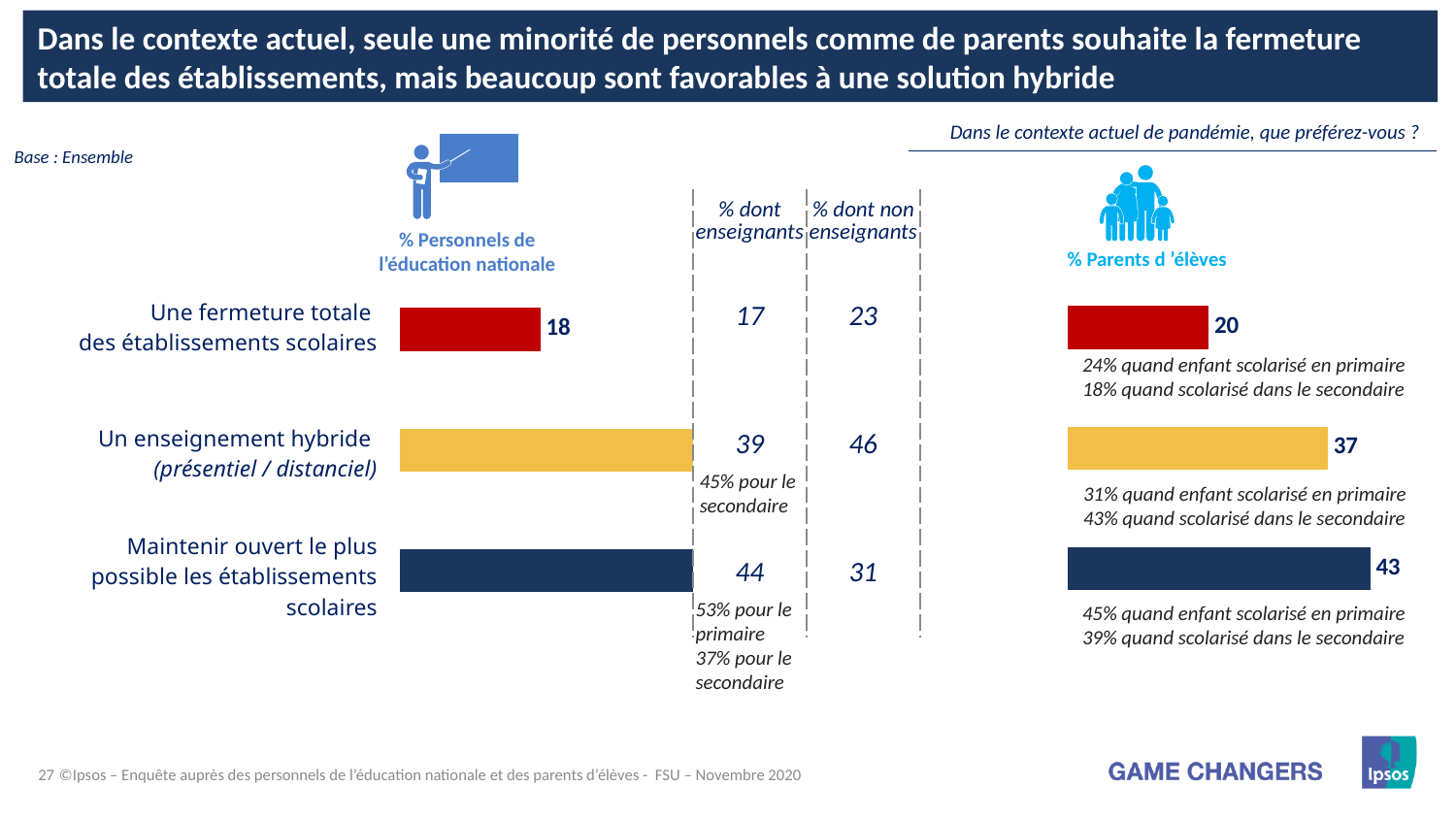
In the '% Parents d'élèves' chart, what is the value for 'Maintenir ouvert le plus possible les établissements scolaires'? 43 In the '% Personnels de l'éducation nationale' chart, what is the value for 'Une fermeture totale des établissements scolaires'? 18 In the '% Parents d'élèves' chart, which option has the lowest value? Une fermeture totale des établissements scolaires What type of chart is used for '% Personnels de l'éducation nationale'? Bar chart In the '% Parents d'élèves' chart, what is the value for 'Une fermeture totale des établissements scolaires'? 20 In the '% Parents d'élèves' chart, what is the difference between 'Maintenir ouvert le plus possible' and 'Une fermeture totale'? 23 For 'Une fermeture totale des établissements scolaires', which is larger: the value in the '% Personnels de l'éducation nationale' chart or the value in the '% Parents d'élèves' chart? % Parents d'élèves In the '% Parents d'élèves' chart, what is the value for 'Un enseignement hybride (présentiel / distanciel)'? 37 How many options (categories) are shown in the '% Parents d'élèves' chart? 3 In the '% Personnels de l'éducation nationale' chart, which option has the shortest bar? Une fermeture totale des établissements scolaires In the '% Parents d'élèves' chart, what is the difference between 'Maintenir ouvert le plus possible' and 'Un enseignement hybride'? 6 In the '% Parents d'élèves' chart, which option has the highest value? Maintenir ouvert le plus possible les établissements scolaires